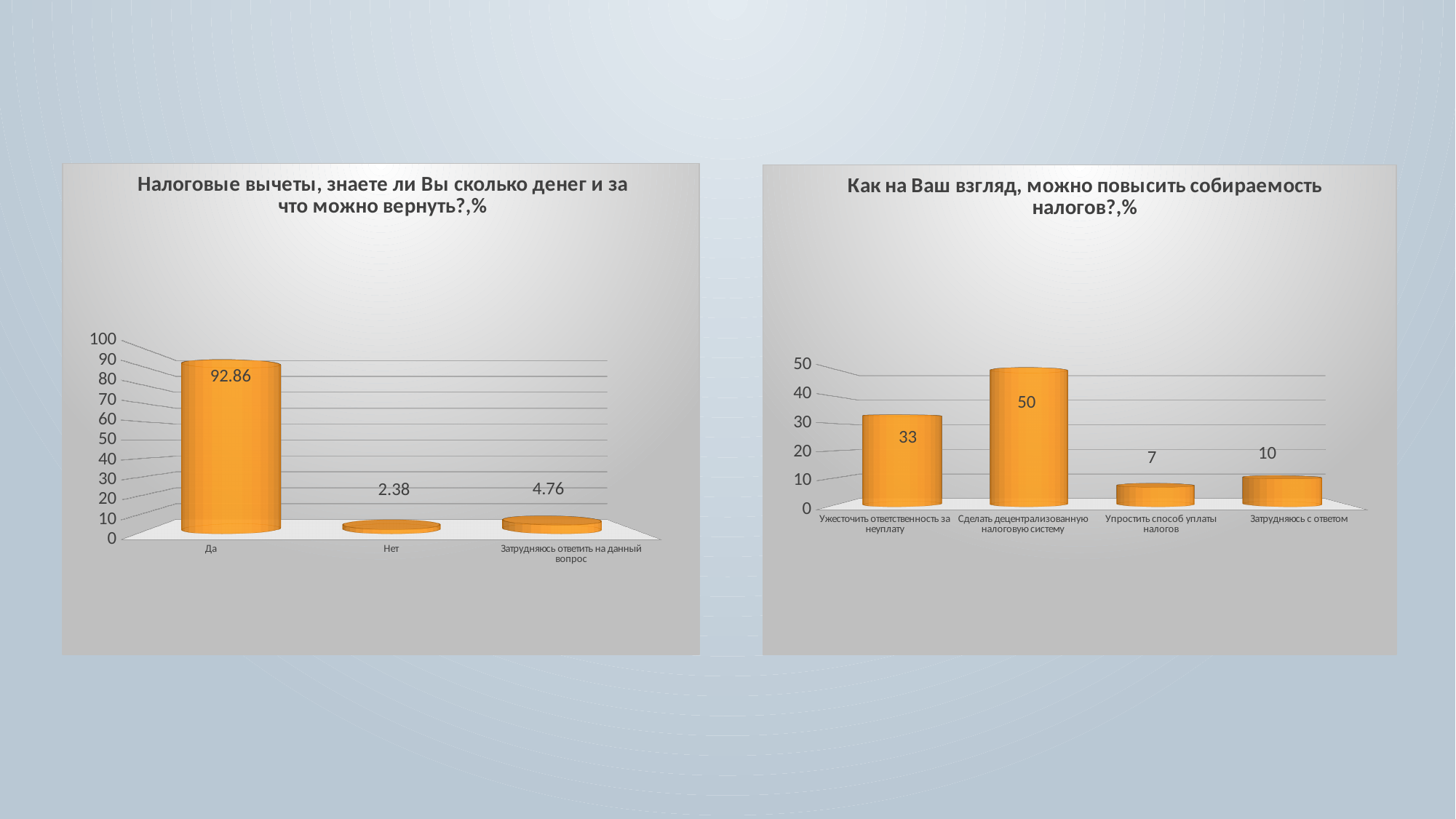
In the right chart (Как на Ваш взгляд...), which category has the highest value? Сделать децентрализованную налоговую систему What type of chart is the left chart (Налоговые вычеты...)? Bar chart In the right chart (Как на Ваш взгляд...), what is the value for "Сделать децентрализованную налоговую систему"? 50 In the left chart (Налоговые вычеты...), what is the difference between the values for "Да" and "Затрудняюсь ответить на данный вопрос"? 88.1 In the right chart (Как на Ваш взгляд...), how many categories are shown? 4 In the right chart (Как на Ваш взгляд...), which is larger: the value for "Ужесточить ответственность за неуплату" or for "Затрудняюсь с ответом"? Ужесточить ответственность за неуплату In the left chart (Налоговые вычеты...), what is the value for "Да"? 92.86 In the right chart (Как на Ваш взгляд...), what is the difference between the values for "Сделать децентрализованную налоговую систему" and "Ужесточить ответственность за неуплату"? 17 In the right chart (Как на Ваш взгляд...), what is the value for "Упростить способ уплаты налогов"? 7 In the left chart (Налоговые вычеты...), what is the value for "Нет"? 2.38 In the left chart (Налоговые вычеты...), how many categories are shown? 3 In the left chart (Налоговые вычеты...), which category has the lowest value? Нет